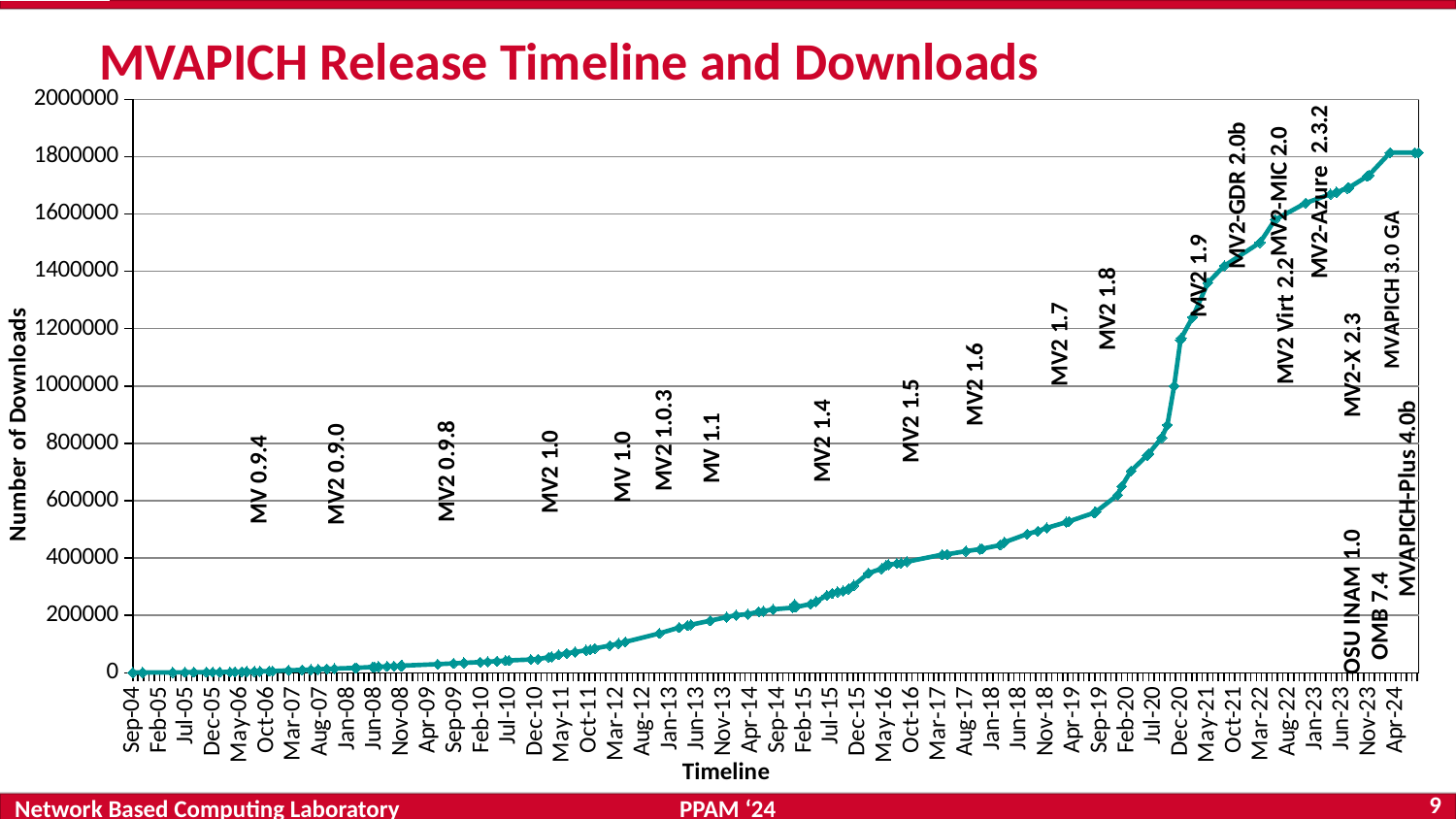
What is the label of the vertical axis? Number of Downloads Is the value for Dec-20 greater or less than 1000000? greater Do the download values rise or fall along the timeline from Sep-04 to Apr-24? rise What is the title of the chart? MVAPICH Release Timeline and Downloads What kind of chart is shown on the slide? line chart Is the value for Jan-13 greater or less than 200000? less Is the value for Oct-16 greater or less than 600000? less Which is larger, the value for Jul-20 or the value for Jul-15? Jul-20 What is the highest value shown on the vertical axis? 2000000 Which is larger, the value for Mar-17 or the value for Dec-20? Dec-20